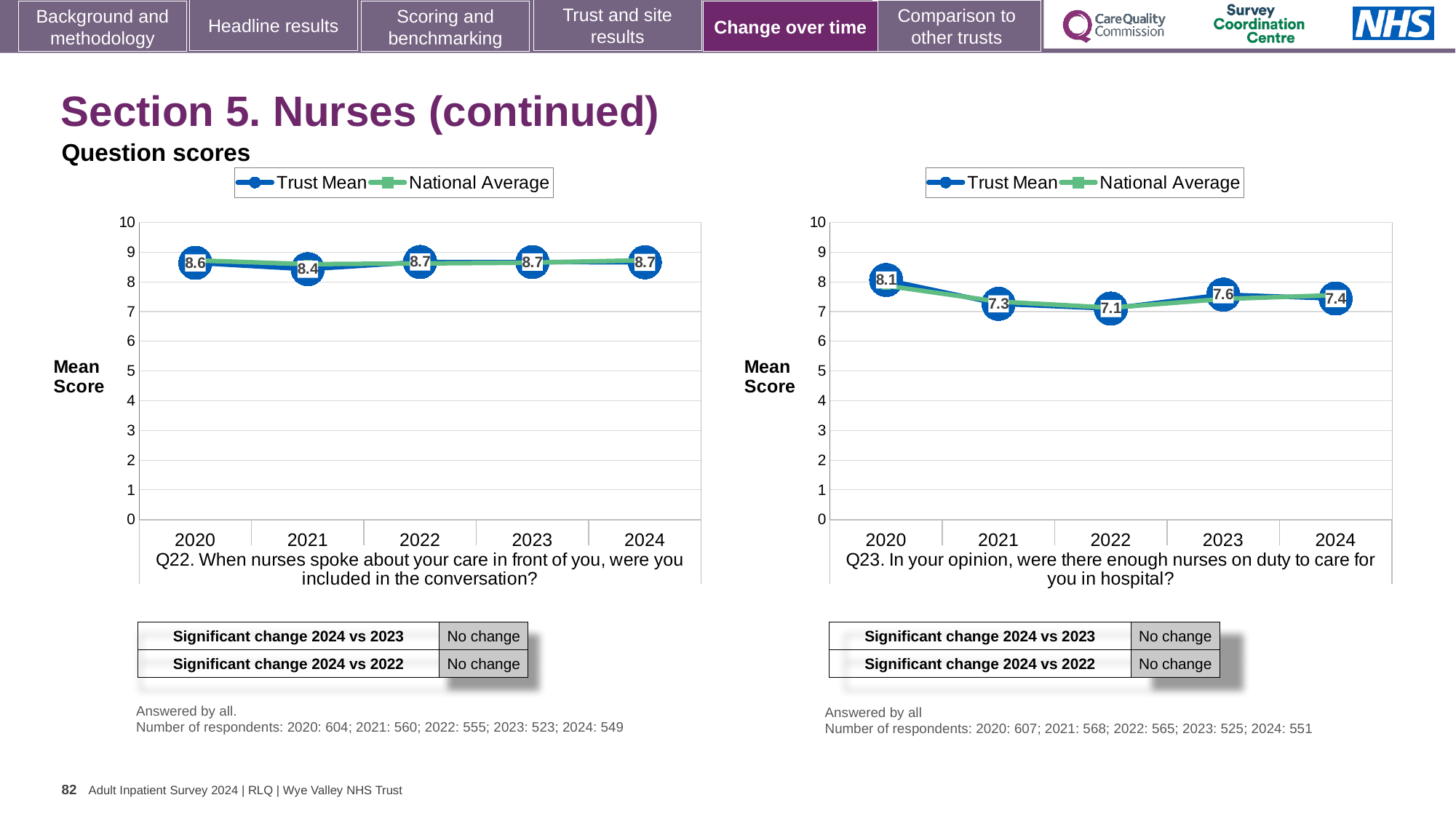
In the Q23 chart on the right, what is the difference between the Trust Mean scores for 2020 and 2024? 0.7 How many series does the legend of the Q23 chart on the right list? 2 In the Q22 chart on the left, what is the Trust Mean score for 2021? 8.4 In the Q23 chart on the right, which year has the lowest Trust Mean score? 2022 In the Q23 chart on the right, what is the Trust Mean score for 2024? 7.4 What kind of chart is the Q23 chart on the right? Line chart How many years are plotted on the x axis of the Q22 chart on the left? 5 In the Q23 chart on the right, what is the Trust Mean score for 2020? 8.1 In the Q23 chart on the right, is the National Average value for 2020 greater or less than 7? greater In the Q22 chart on the left, which year has the lowest Trust Mean score? 2021 In the Q22 chart on the left, is the Trust Mean score higher in 2021 or in 2022? 2022 In the Q23 chart on the right, which year has the highest Trust Mean score? 2020